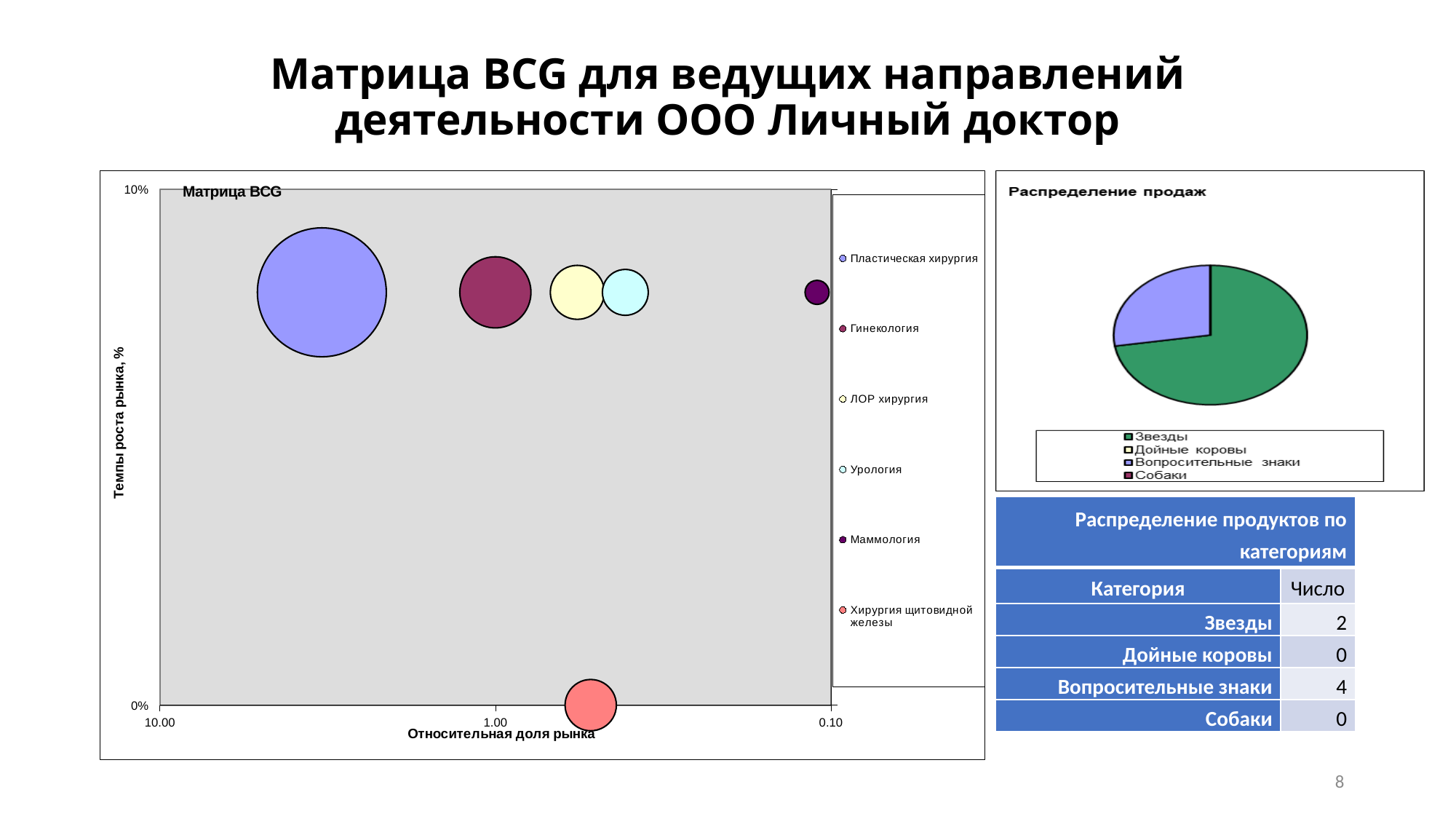
In the "Матрица BCG" chart, which series has the largest bubble? Пластическая хирургия What kind of chart is the chart titled "Распределение продаж" on the right of the slide? pie chart What colour represents Звезды in the "Распределение продаж" pie chart? green How many series does the legend of the "Матрица BCG" chart list? 6 In the "Матрица BCG" chart, which series has the lowest market growth rate (Темпы роста рынка)? Хирургия щитовидной железы How many entries does the legend of the "Распределение продаж" pie chart list? 4 What is the label of the x axis of the "Матрица BCG" chart? Относительная доля рынка In the "Матрица BCG" chart, which series has the highest relative market share (Относительная доля рынка)? Пластическая хирургия How many slices are visible in the "Распределение продаж" pie chart? 2 In the "Распределение продаж" pie chart, which slice is larger: Звезды or Вопросительные знаки? Звезды In the "Матрица BCG" chart, which series has the smallest bubble? Маммология What kind of chart is the chart titled "Матрица BCG" on the left of the slide? bubble chart